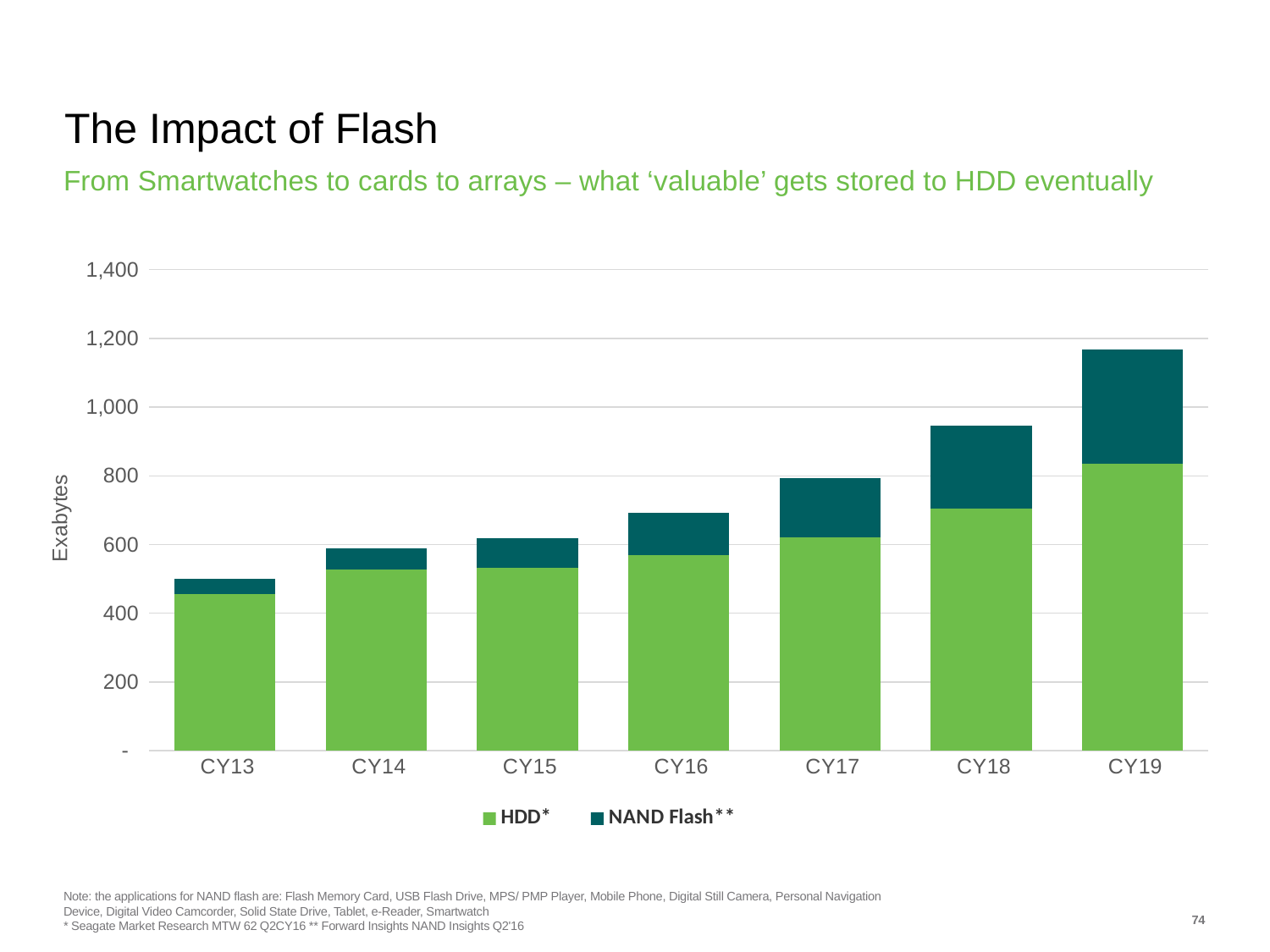
Which year has the highest total stacked bar? CY19 Which year has the lowest total stacked bar? CY13 Which year has the larger total stacked bar, CY17 or CY18? CY18 Is the total stacked value for CY19 greater or less than 1,000? greater What is the label on the chart's vertical axis? Exabytes Is the total stacked value for CY13 greater or less than 600? less How many series does the chart's legend list? 2 Is the total stacked value for CY18 greater or less than 1,000? less How many categories (years) are shown on the x axis of the chart? 7 Do the total bar heights rise or fall from CY13 to CY19? rise What kind of chart is shown on the slide? stacked bar chart